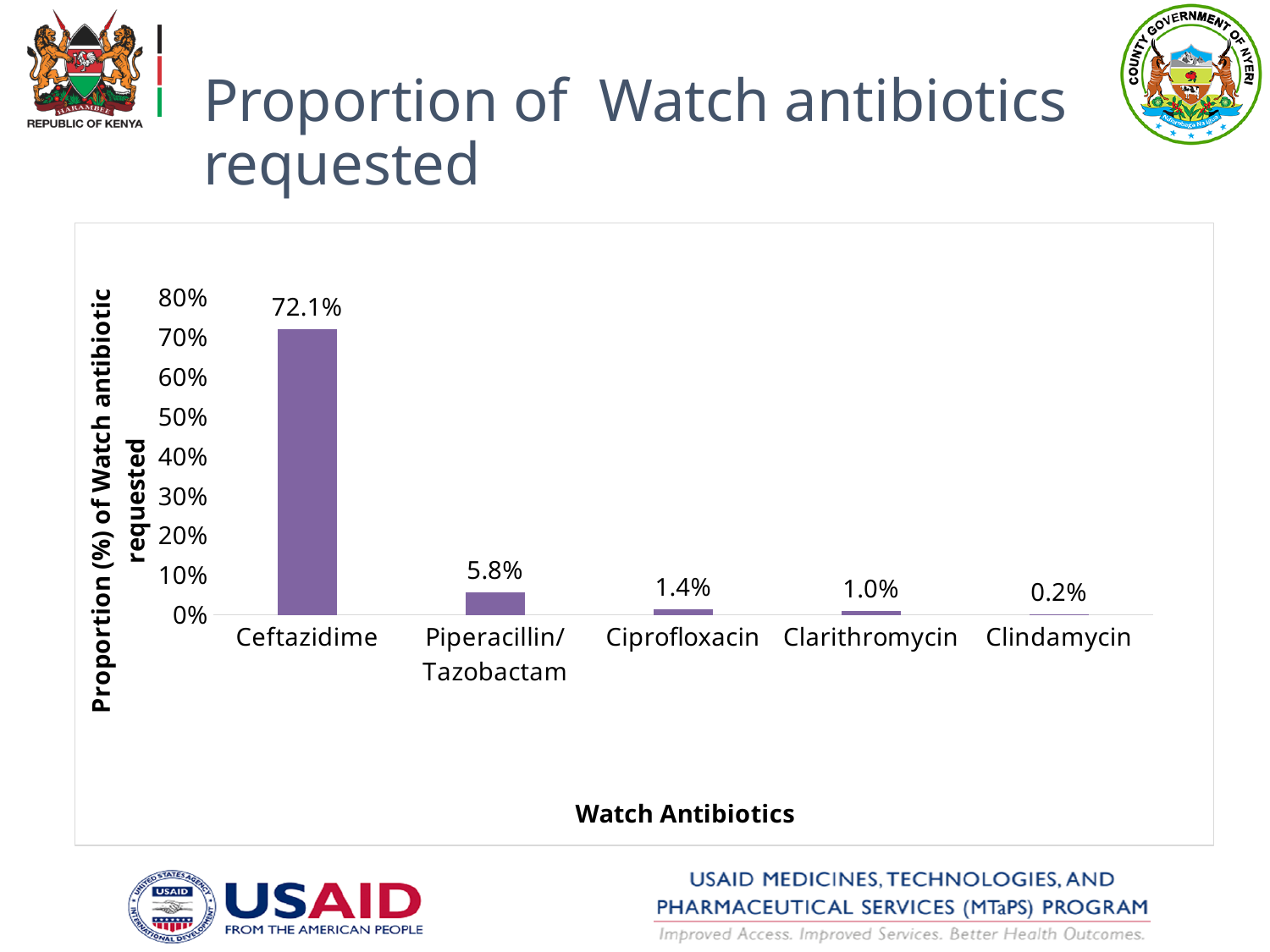
What is the proportion of Watch antibiotic requested for Clindamycin? 0.2% What is the proportion of Watch antibiotic requested for Ceftazidime? 72.1% What is the proportion of Watch antibiotic requested for Ciprofloxacin? 1.4% What is the difference between the proportions for Ciprofloxacin and Clarithromycin? 0.4% Which has a larger proportion requested, Piperacillin/Tazobactam or Ciprofloxacin? Piperacillin/Tazobactam What is the difference between the proportions for Ceftazidime and Piperacillin/Tazobactam? 66.3% What is the proportion of Watch antibiotic requested for Piperacillin/Tazobactam? 5.8% What is the label of the x axis of the chart? Watch Antibiotics Which Watch antibiotic has the lowest proportion requested? Clindamycin How many Watch antibiotics are shown on the x axis of the chart? 5 Which Watch antibiotic has the highest proportion requested? Ceftazidime What kind of chart is shown on the slide? Bar chart